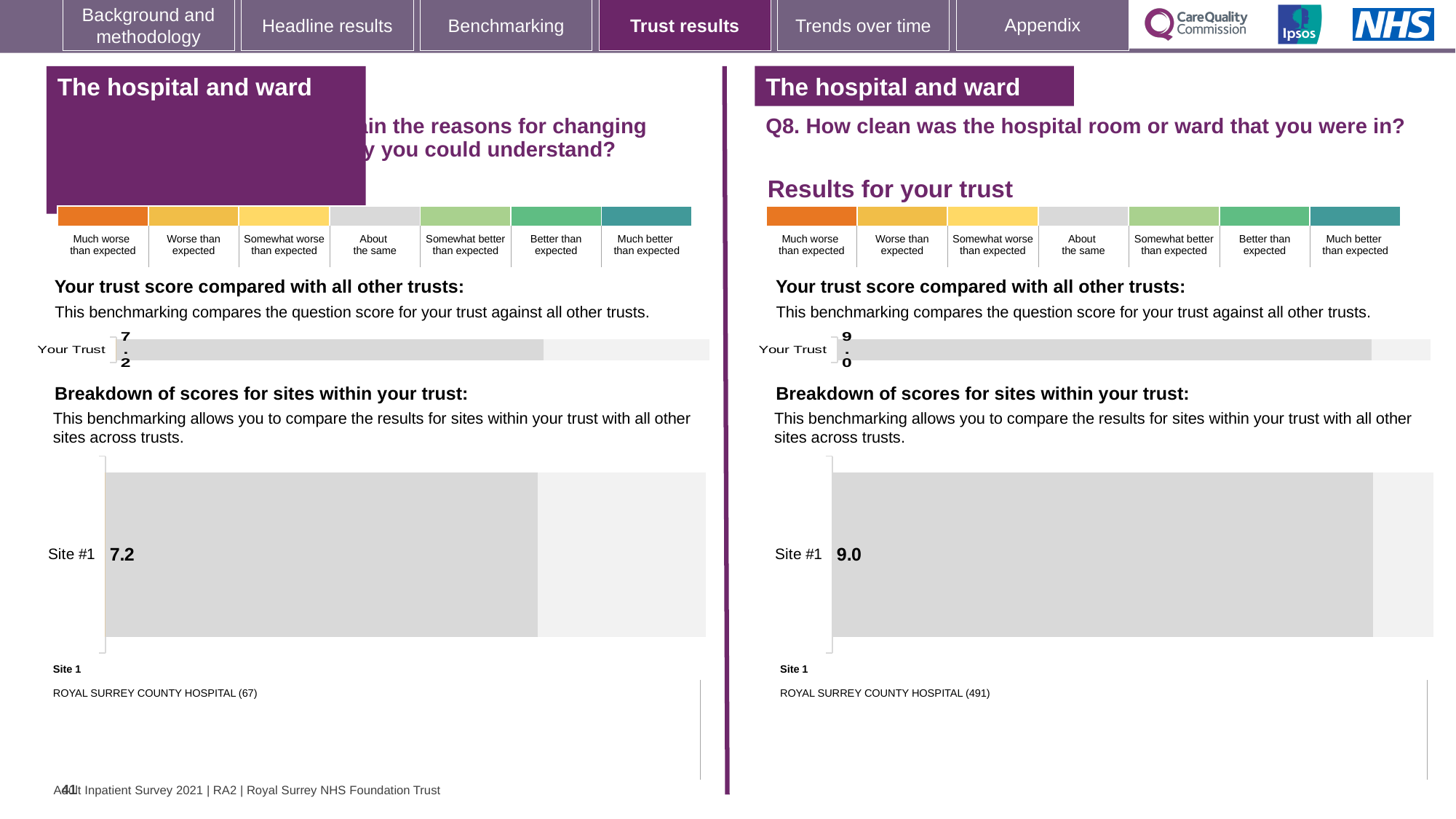
On the left-hand chart, what is the score shown for Site #1? 7.2 On the left-hand chart, which site is listed as Site 1? ROYAL SURREY COUNTY HOSPITAL (67) On the left-hand chart, what is the score shown for Your Trust? 7.2 On the right-hand chart (Q8. How clean was the hospital room or ward that you were in?), what is the score shown for Your Trust? 9.0 What is the difference between the Site #1 score on the right-hand chart (Q8) and the Site #1 score on the left-hand chart? 1.8 How many sites are shown in the site breakdown chart on the right-hand side (Q8)? 1 On the right-hand chart (Q8), what is the score shown for Site #1? 9.0 What type of chart is used to show the Site #1 score on the right-hand chart (Q8)? Bar chart Which is larger: the Site #1 score on the left-hand chart or the Site #1 score on the right-hand chart (Q8)? Right-hand chart (Q8) How many sites are shown in the site breakdown chart on the left-hand side? 1 On the right-hand chart (Q8), which site is listed as Site 1? ROYAL SURREY COUNTY HOSPITAL (491) Is the Your Trust score on the left-hand chart greater or less than the Your Trust score on the right-hand chart (Q8)? less